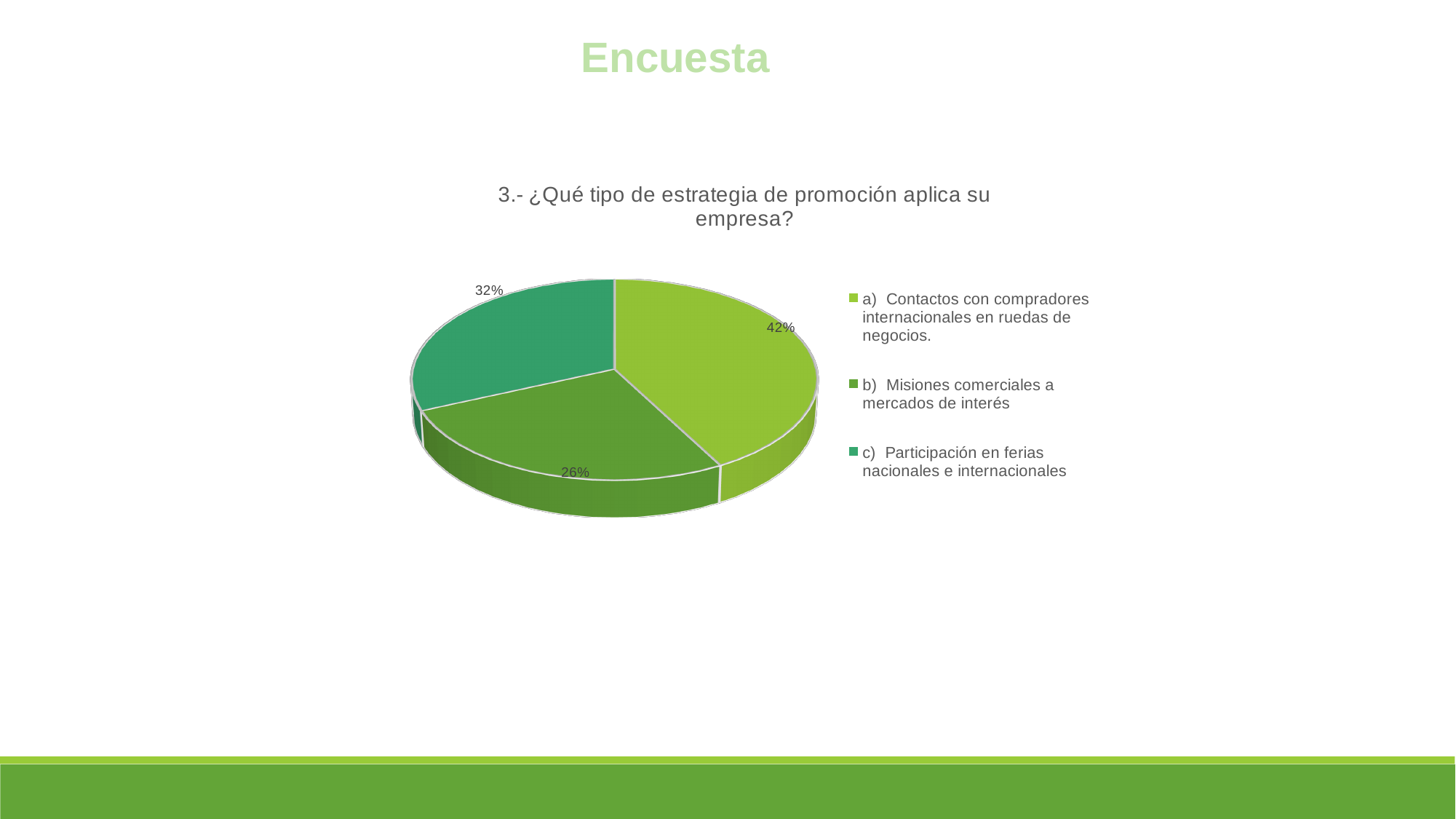
What is the difference in percentage points between option c) and option b)? 6 What percentage is shown for option c) Participación en ferias nacionales e internacionales? 32% What is the chart's title? 3.- ¿Qué tipo de estrategia de promoción aplica su empresa? What percentage is shown for option b) Misiones comerciales a mercados de interés? 26% Which option has the smallest share of the pie? b) Misiones comerciales a mercados de interés How many entries does the legend list? 3 Which is larger, the share for option a) or the share for option c)? a) Contactos con compradores internacionales en ruedas de negocios. How many slices does the pie chart have? 3 What is the difference in percentage points between option a) and option b)? 16 What percentage is shown for option a) Contactos con compradores internacionales en ruedas de negocios? 42% Which option has the largest share of the pie? a) Contactos con compradores internacionales en ruedas de negocios. What type of chart is shown on the slide? Pie chart